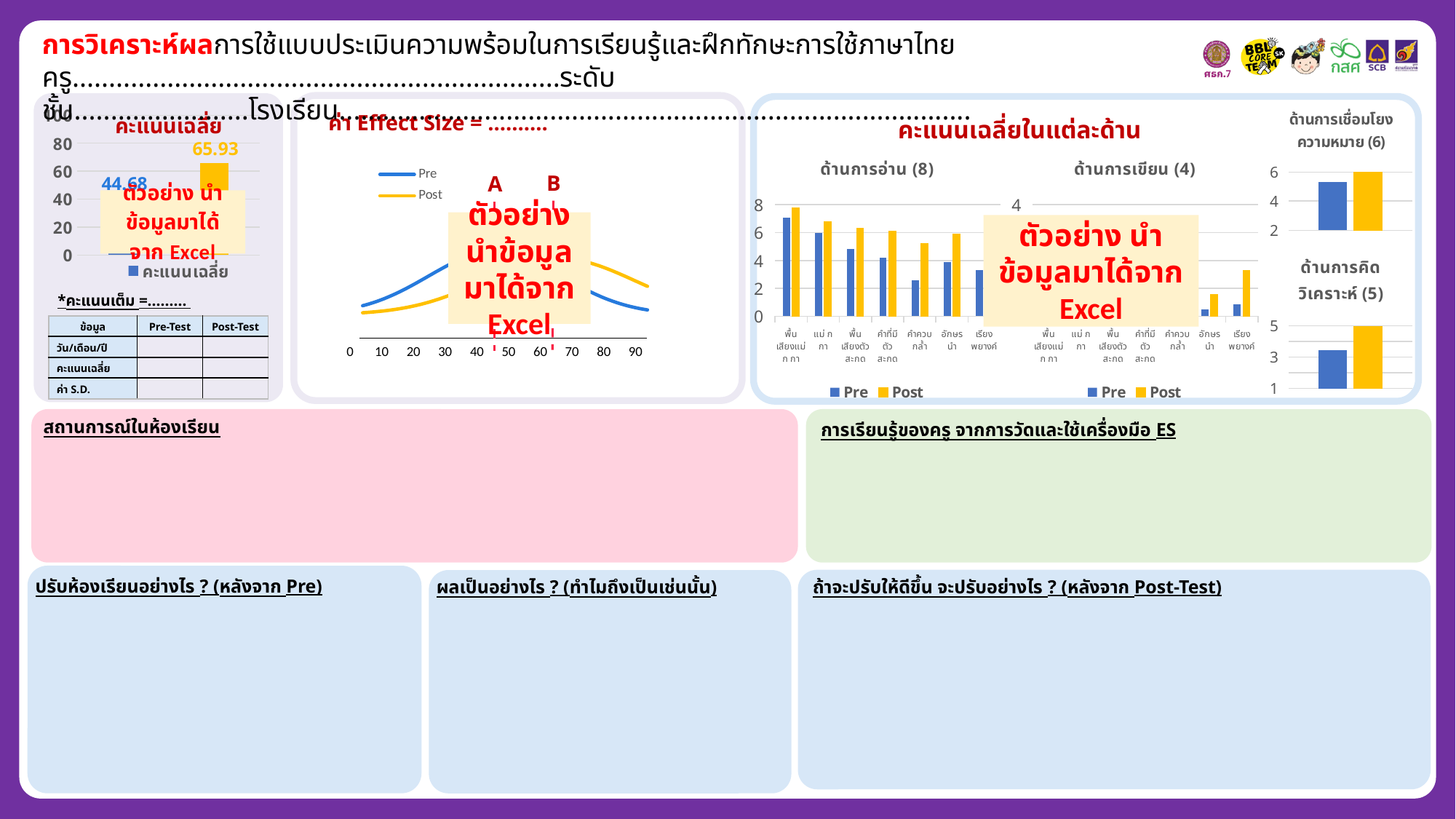
In the ด้านการอ่าน (8) chart, is the Pre value for พื้นเสียงแม่ ก กา greater or less than 6? greater In the ด้านการอ่าน (8) chart, how many categories are shown on the x axis? 7 In the ค่า Effect Size chart, which colour is the Post line? yellow What kind of chart is the คะแนนเฉลี่ย chart at the top left? bar chart What kind of chart is the ค่า Effect Size chart in the middle of the slide? line chart In the คะแนนเฉลี่ย chart at the top left, which bar is taller, the blue one or the yellow one? the yellow one In the คะแนนเฉลี่ย chart at the top left, what value is printed on the yellow bar? 65.93 How many series does the legend of the ค่า Effect Size chart list? 2 In the คะแนนเฉลี่ย chart at the top left, what is the difference between the yellow bar (65.93) and the blue bar (44.68)? 21.25 In the ด้านการคิดวิเคราะห์ (5) chart, which bar is taller, Pre or Post? Post In the ด้านการอ่าน (8) chart, which category has the highest Post value? พื้นเสียงแม่ ก กา In the คะแนนเฉลี่ย chart at the top left, what value is printed on the blue bar? 44.68